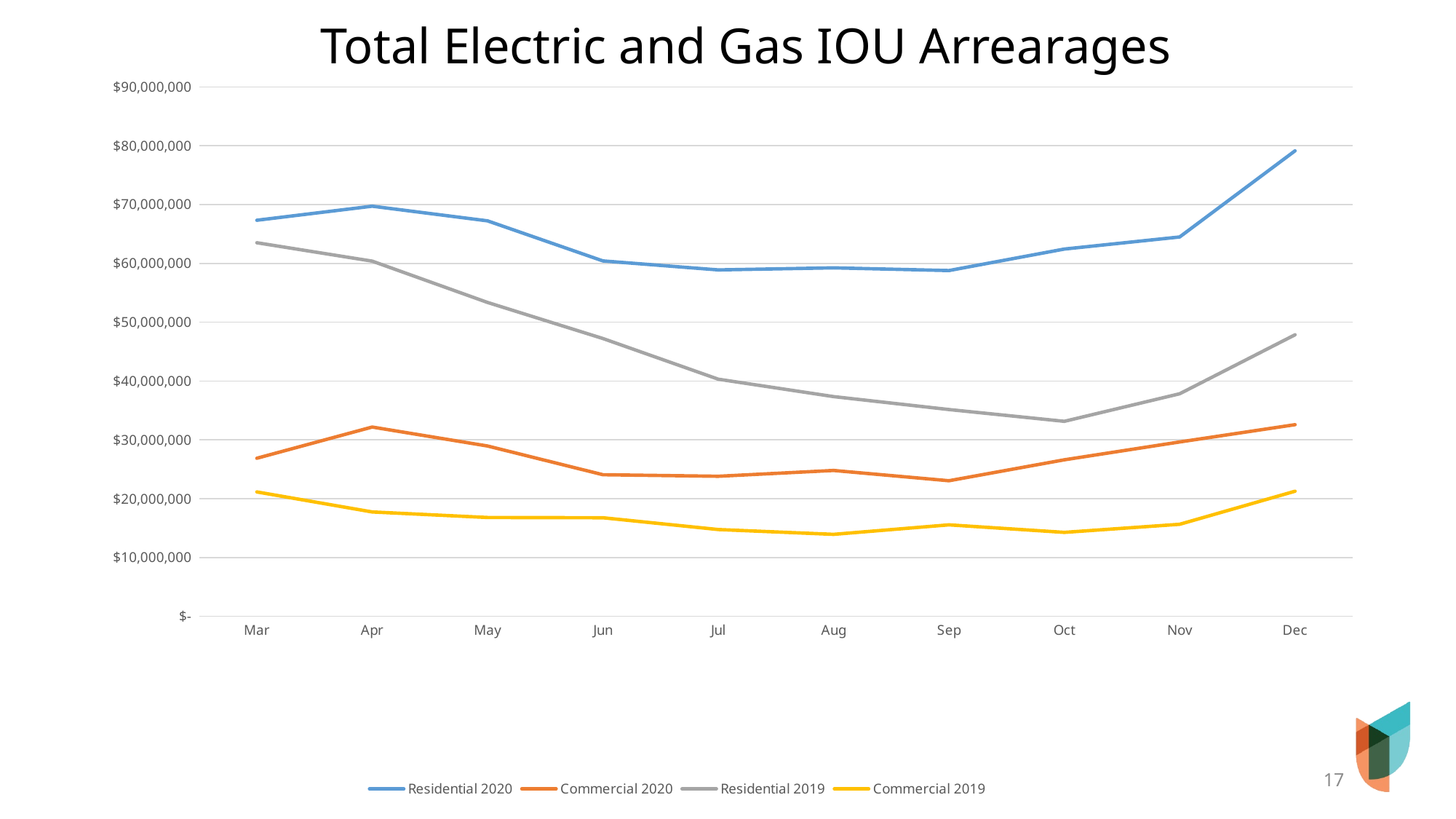
In Apr, which is larger: Commercial 2020 or Commercial 2019? Commercial 2020 Is the value for Residential 2020 in Dec greater or less than $70,000,000? greater How many months are shown along the x axis? 10 How many series does the legend list? 4 Does the Residential 2019 line rise or fall from Mar to Oct? fall Is the value for Residential 2019 in Oct greater or less than $40,000,000? less In which month is the Residential 2019 line at its lowest? Oct Is the value for Residential 2019 in May greater or less than $50,000,000? greater What kind of chart is shown on the slide? line chart In which month is the Residential 2020 line at its highest? Dec What is the title of the chart? Total Electric and Gas IOU Arrearages